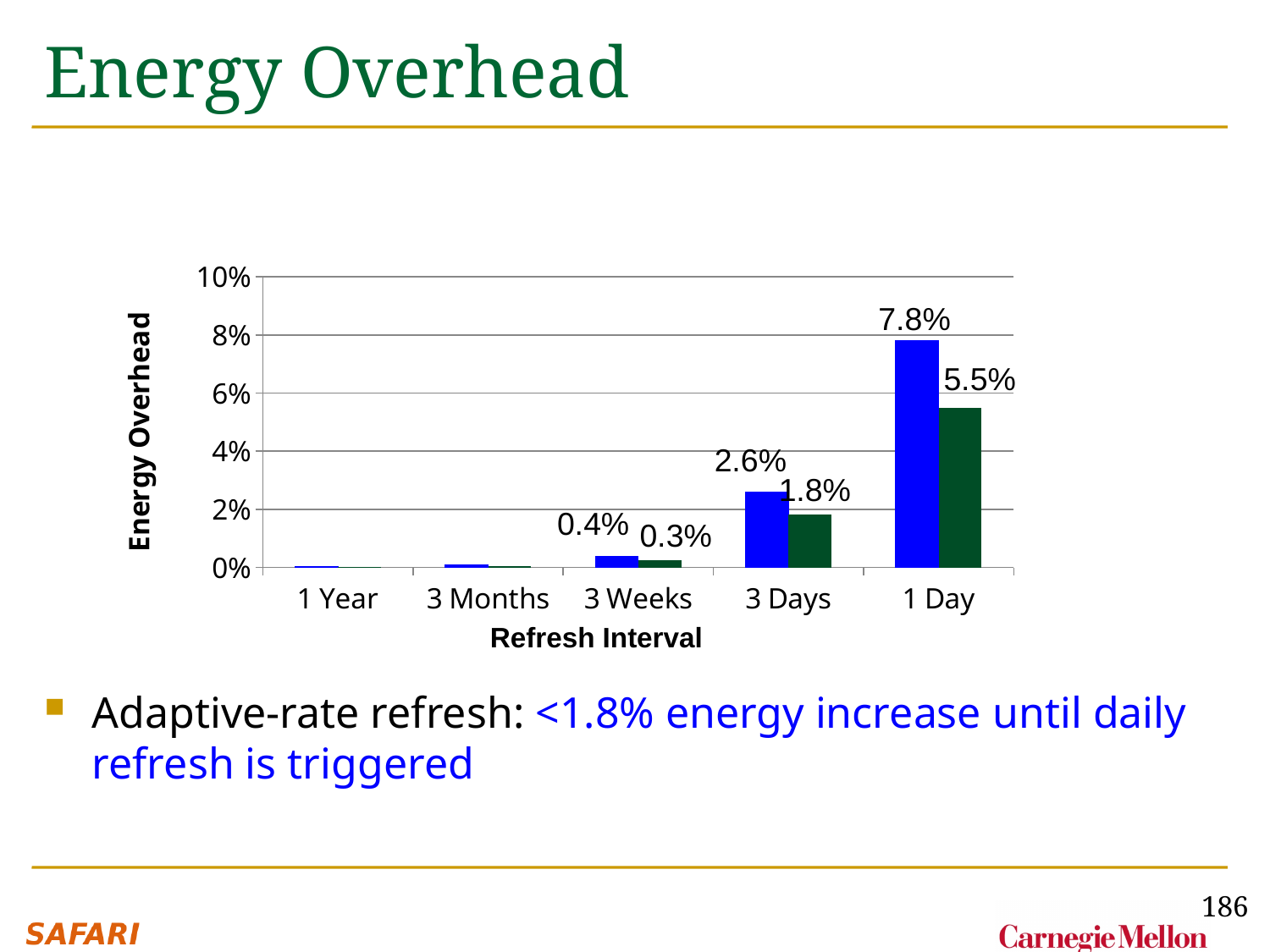
Do the energy overhead values rise or fall moving from 1 Year to 1 Day along the x axis? rise What kind of chart is shown on the slide? bar chart How many refresh intervals are shown on the x axis? 5 Is the value of the blue bar for 1 Day greater or less than 6%? greater For the 3 Days refresh interval, which bar is larger, the blue or the green? blue What is the difference between the blue and green bars for the 3 Days refresh interval? 0.8% What is the value of the blue bar for the 1 Day refresh interval? 7.8% What is the value of the green bar for the 3 Weeks refresh interval? 0.3% Which refresh interval has the highest energy overhead? 1 Day What is the value of the green bar for the 1 Day refresh interval? 5.5% What is the difference between the blue and green bars for the 1 Day refresh interval? 2.3% What is the value of the blue bar for the 3 Days refresh interval? 2.6%